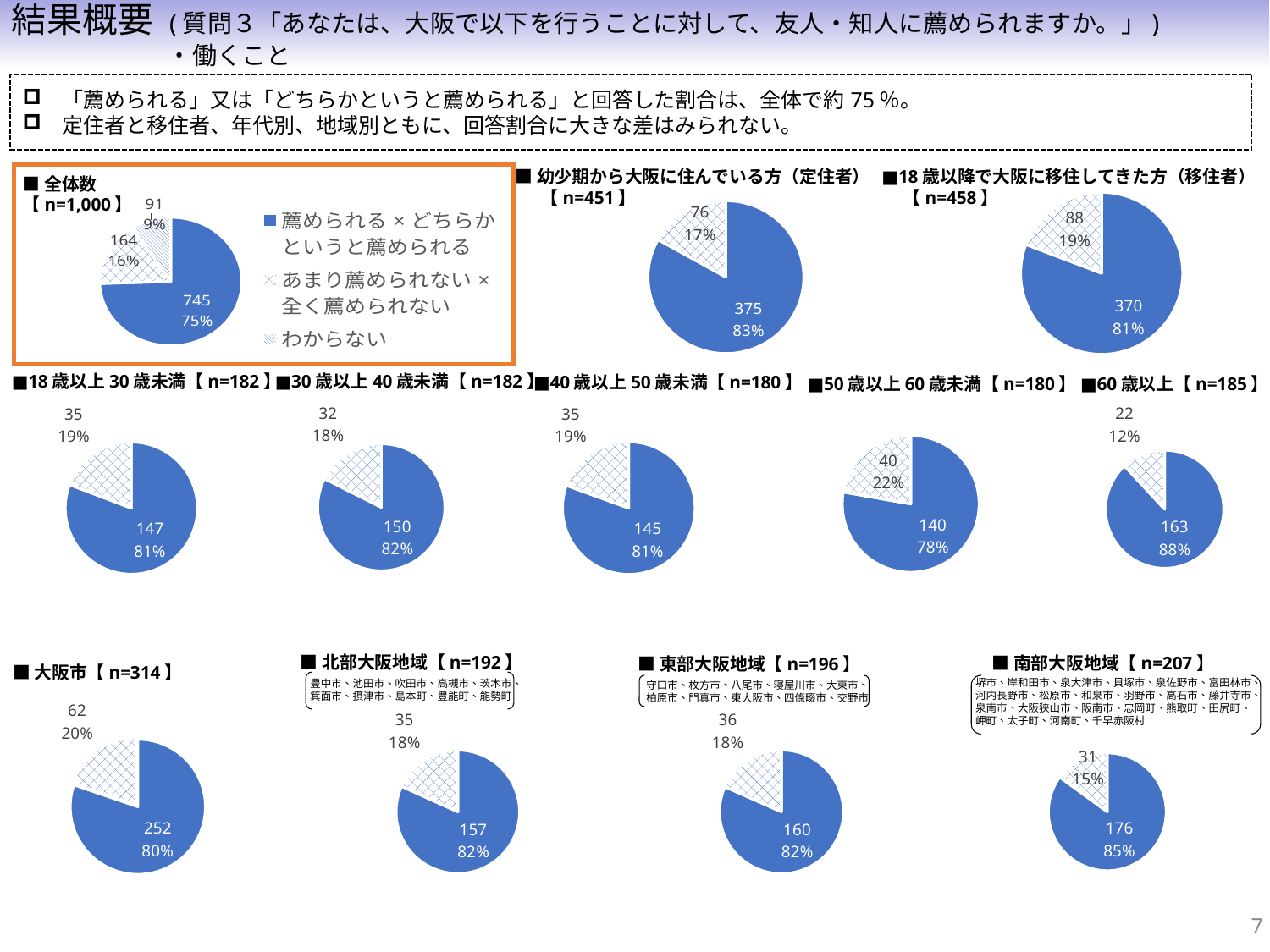
Which of the age-group pie charts shows the highest percentage for the larger slice? 60歳以上【n=185】 In the 全体数【n=1,000】 pie chart, what percentage share does the わからない slice have? 9% In the 50歳以上60歳未満【n=180】 pie chart, what is the difference between the two slice counts (140 and 40)? 100 What type of chart is used for the 全体数【n=1,000】 data? Pie chart Which of the age-group pie charts shows the lowest percentage for the larger slice? 50歳以上60歳未満【n=180】 In the 大阪市【n=314】 pie chart, what is the count for the larger slice? 252 In the 全体数【n=1,000】 pie chart, what is the count for 薦められる × どちらかというと薦められる? 745 How many entries does the legend of the 全体数【n=1,000】 pie chart list? 3 Which has a larger percentage for the main slice: the 南部大阪地域【n=207】 pie chart or the 北部大阪地域【n=192】 pie chart? 南部大阪地域【n=207】 In the 18歳以降で大阪に移住してきた方（移住者）【n=458】 pie chart, what is the count for the smaller slice? 88 In the 幼少期から大阪に住んでいる方（定住者）【n=451】 pie chart, what percentage is shown for the larger slice? 83% In the 東部大阪地域【n=196】 pie chart, what is the total of the two slice counts (160 and 36)? 196